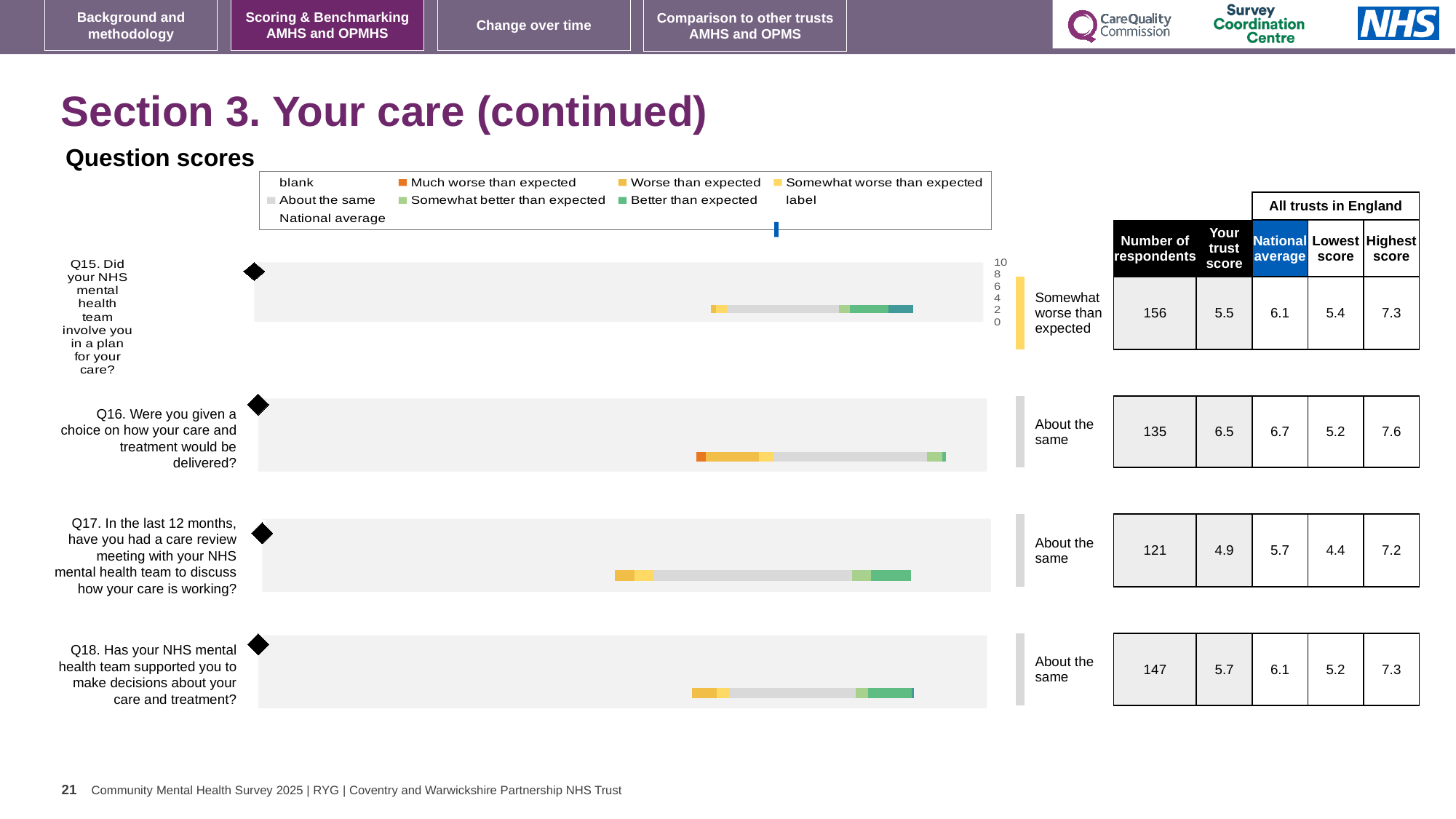
Which question has the lowest 'Your trust score' among Q15 to Q18? Q17 What is the difference between the national average and the trust score for Q15? 0.6 How many questions (Q15 to Q18) have a bar plotted on the slide? 4 Which question has the highest 'Your trust score' among Q15 to Q18? Q16 What is the 'Your trust score' value for Q15 (involving you in a plan for your care)? 5.5 Which question has the most respondents among Q15 to Q18? Q15 What is the highest score among all trusts in England for Q18 (supported to make decisions about care and treatment)? 7.3 How many respondents answered Q17 (care review meeting in the last 12 months)? 121 What is the national average score for Q16 (choice on how care and treatment would be delivered)? 6.7 What benchmark rating label is shown next to the bar for Q15? Somewhat worse than expected What kind of chart is used to show the question scores for Q15 to Q18? bar chart Which has the larger trust score: Q16 or Q17? Q16